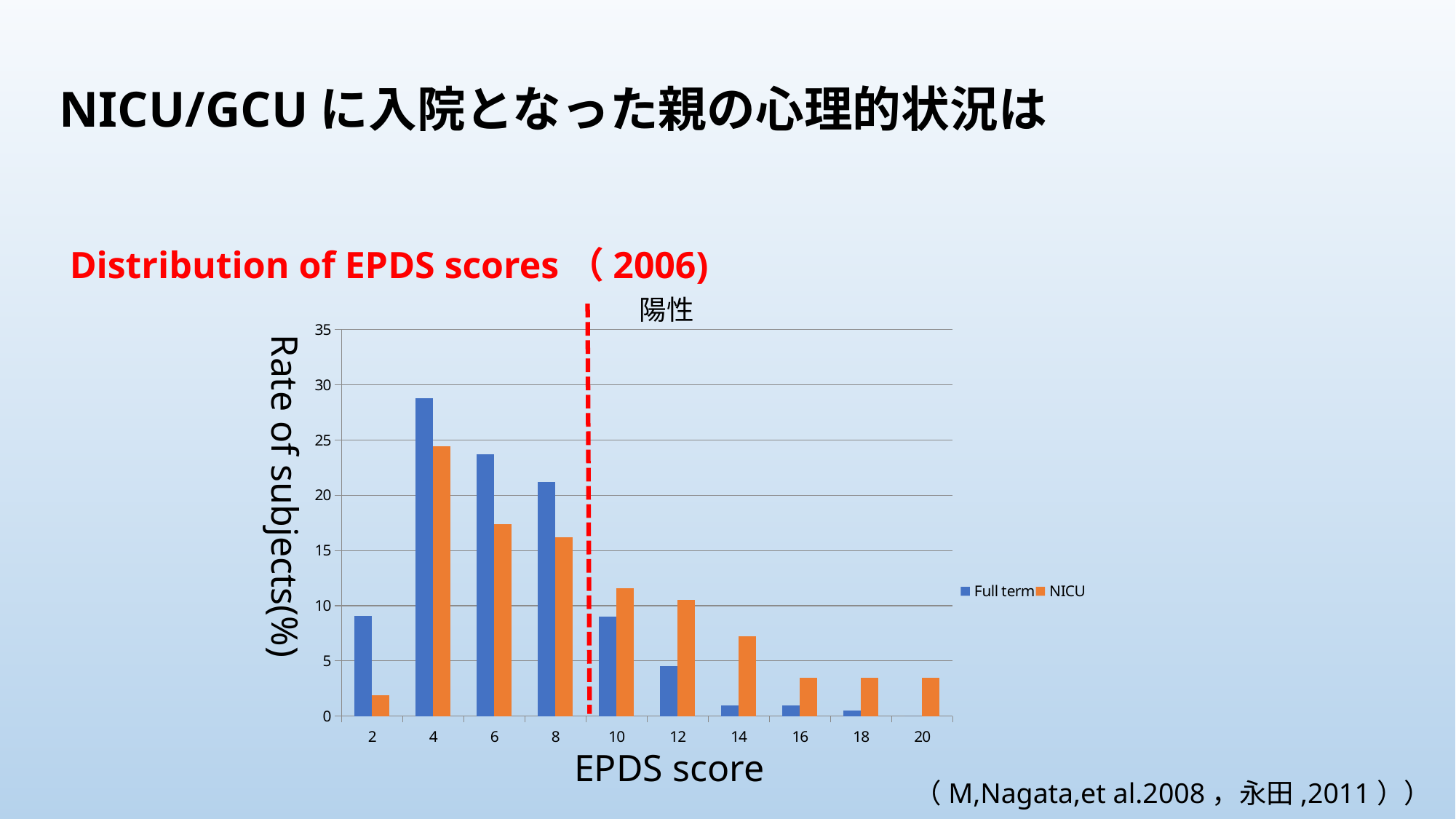
Do the Full term values rise or fall from EPDS score 4 to EPDS score 20? fall How many EPDS score categories are shown on the x axis? 10 Is the Full term value at EPDS score 4 greater or less than 25? greater At which EPDS score is the Full term value highest? 4 At which EPDS score is the NICU value highest? 4 At EPDS score 10, which series has the larger value, Full term or NICU? NICU Is the NICU value at EPDS score 6 greater or less than 15? greater How many series does the legend list? 2 Is the NICU value at EPDS score 14 greater or less than 5? greater At EPDS score 6, which series has the larger value, Full term or NICU? Full term What type of chart is shown on the slide? bar chart